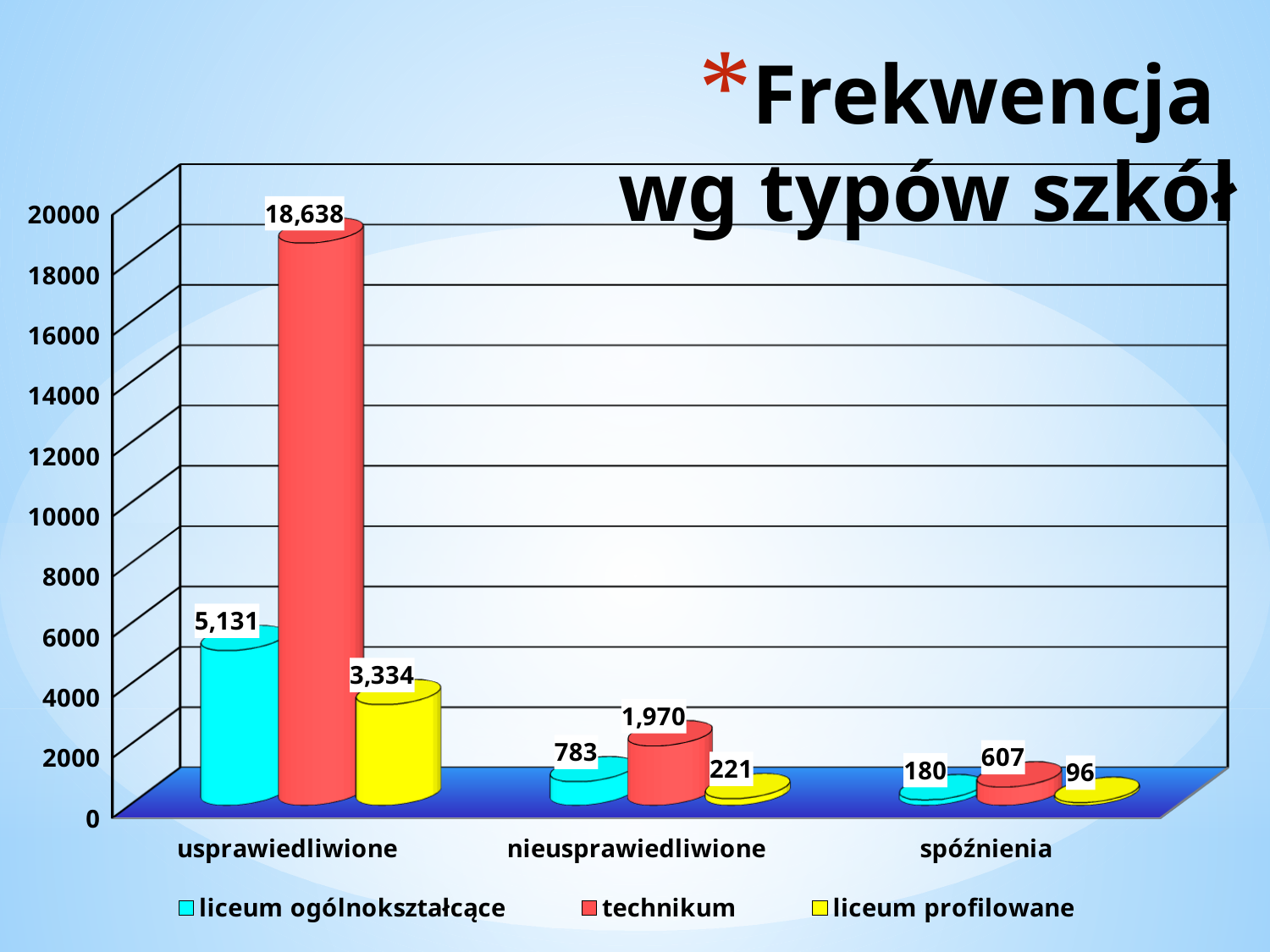
How many categories are shown on the x axis? 3 What is the value for liceum ogólnokształcące in the nieusprawiedliwione category? 783 How many series does the legend list? 3 Which series has the lowest value in the spóźnienia category? liceum profilowane What is the difference between the technikum and liceum ogólnokształcące values in the usprawiedliwione category? 13,507 Which series has the highest value in the usprawiedliwione category? technikum What is the value for liceum profilowane in the spóźnienia category? 96 Which is larger: the liceum profilowane value for usprawiedliwione or the technikum value for nieusprawiedliwione? liceum profilowane value for usprawiedliwione Is the value for liceum ogólnokształcące in the usprawiedliwione category greater or less than 4000? greater What kind of chart is shown on the slide? bar chart What is the title of the slide? Frekwencja wg typów szkół What is the value for technikum in the usprawiedliwione category? 18,638